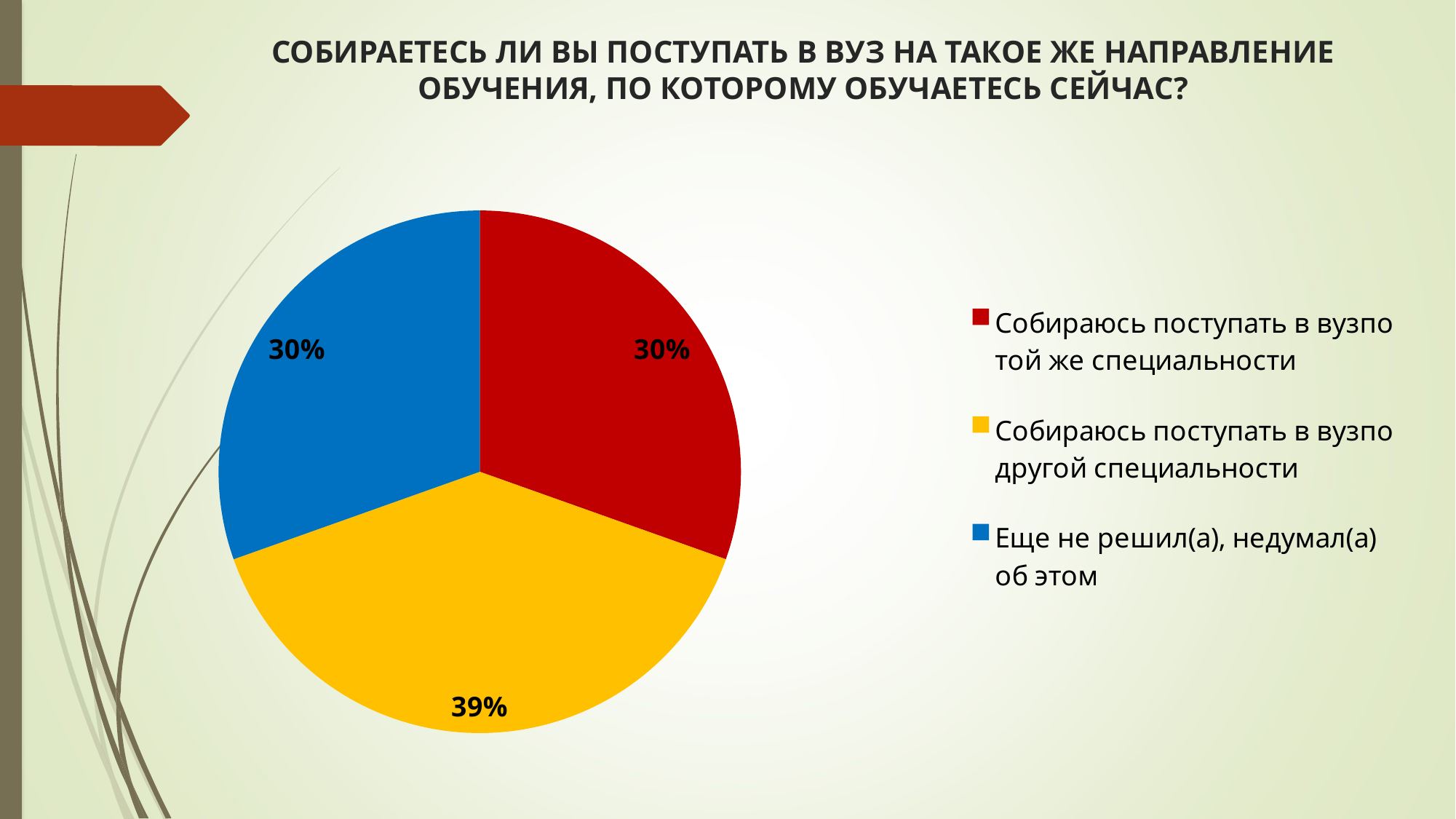
What share of the pie is labelled "Собираюсь поступать в вуз по той же специальности"? 30% What share of the pie is labelled "Собираюсь поступать в вуз по другой специальности"? 39% Which is larger: the share for "Собираюсь поступать в вуз по другой специальности" or the share for "Собираюсь поступать в вуз по той же специальности"? Собираюсь поступать в вуз по другой специальности What colour is the slice for "Еще не решил(а), не думал(а) об этом"? blue What is the difference between the share for "Собираюсь поступать в вуз по другой специальности" and the share for "Еще не решил(а), не думал(а) об этом"? 9% What kind of chart is shown on the slide? pie chart What share of the pie is labelled "Еще не решил(а), не думал(а) об этом"? 30% Which category has the largest slice of the pie? Собираюсь поступать в вуз по другой специальности What colour is the slice for "Собираюсь поступать в вуз по другой специальности"? yellow How many entries does the legend list? 3 How many slices does the pie chart have? 3